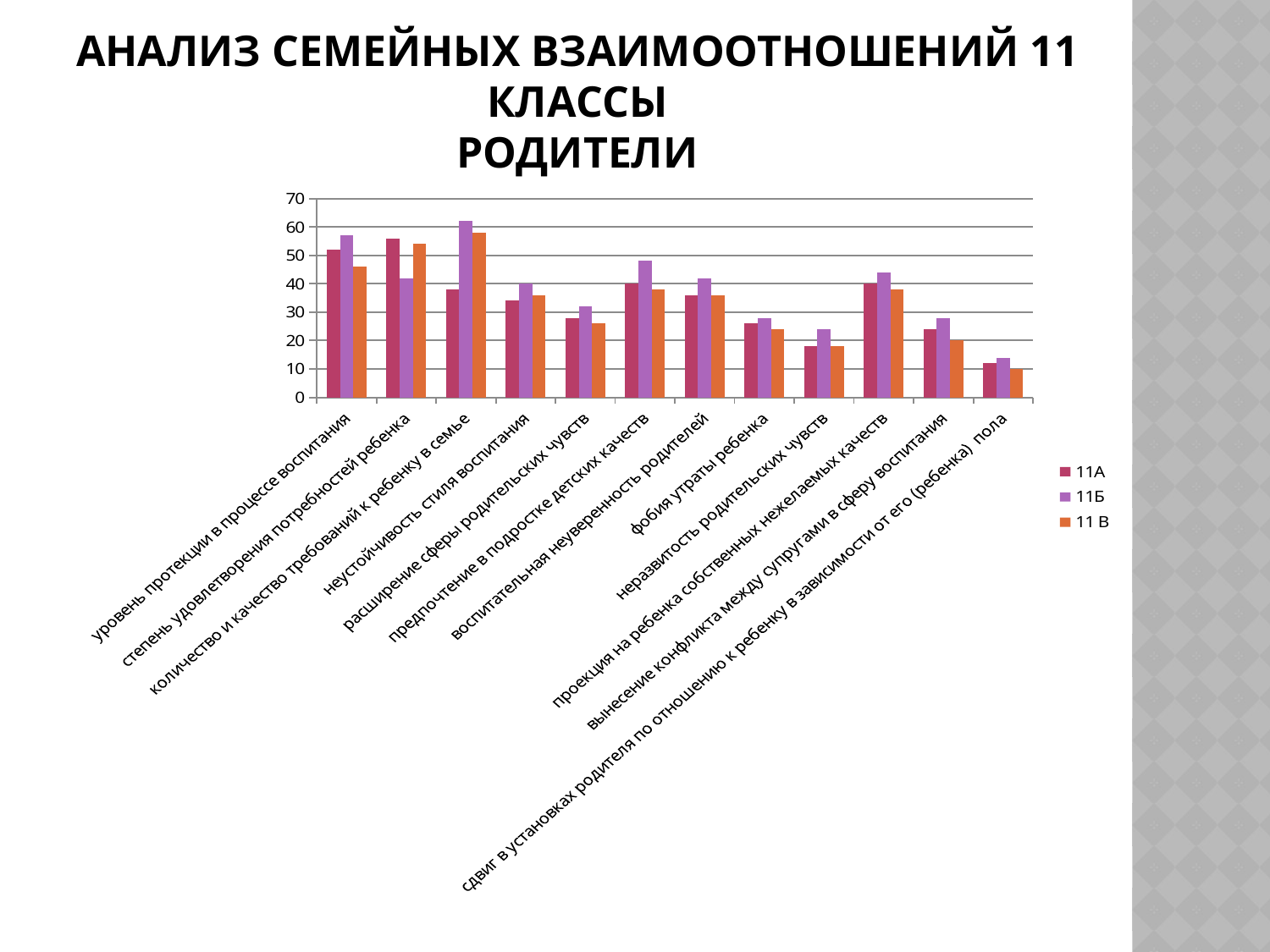
Is the value for 11Б in 'уровень протекции в процессе воспитания' greater or less than 50? greater Is the value for 11Б in 'предпочтение в подростке детских качеств' greater or less than 40? greater Is the value for 11 В in 'уровень протекции в процессе воспитания' greater or less than 50? less How many categories are shown on the x axis? 12 Which category has the lowest bars overall? сдвиг в установках родителя по отношению к ребенку в зависимости от его (ребенка) пола In 'степень удовлетворения потребностей ребенка', which is larger: 11А or 11Б? 11А What kind of chart is shown on the slide? bar chart How many series does the legend list? 3 In 'количество и качество требований к ребенку в семье', which is larger: 11А or 11Б? 11Б Which series are listed in the legend? 11А, 11Б, 11 В For which category and series is the tallest bar in the chart? количество и качество требований к ребенку в семье, 11Б